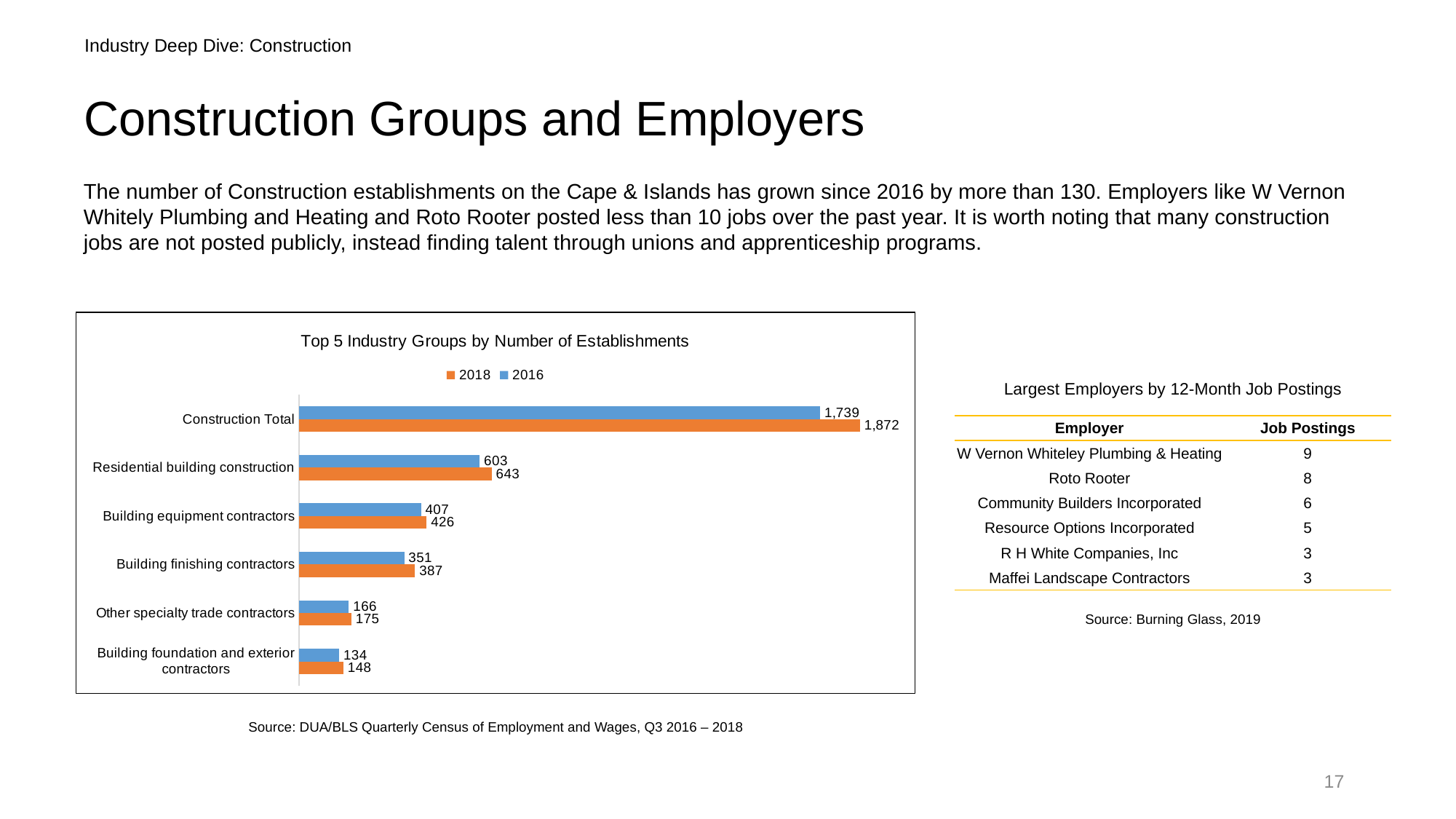
How many categories are shown on the bar chart? 6 Which industry group has the lowest 2016 value? Building foundation and exterior contractors What is the 2016 value for Residential building construction? 603 What is the 2016 value for Building foundation and exterior contractors? 134 What is the difference between the 2018 and 2016 values for Construction Total? 133 How many series does the legend list? 2 What kind of chart is shown on the slide? Bar chart Excluding Construction Total, which industry group has the highest 2018 value? Residential building construction Which is larger for Other specialty trade contractors, the 2018 value or the 2016 value? 2018 What is the 2018 value for Construction Total? 1,872 What is the 2018 value for Building finishing contractors? 387 What is the difference between the 2018 and 2016 values for Building equipment contractors? 19